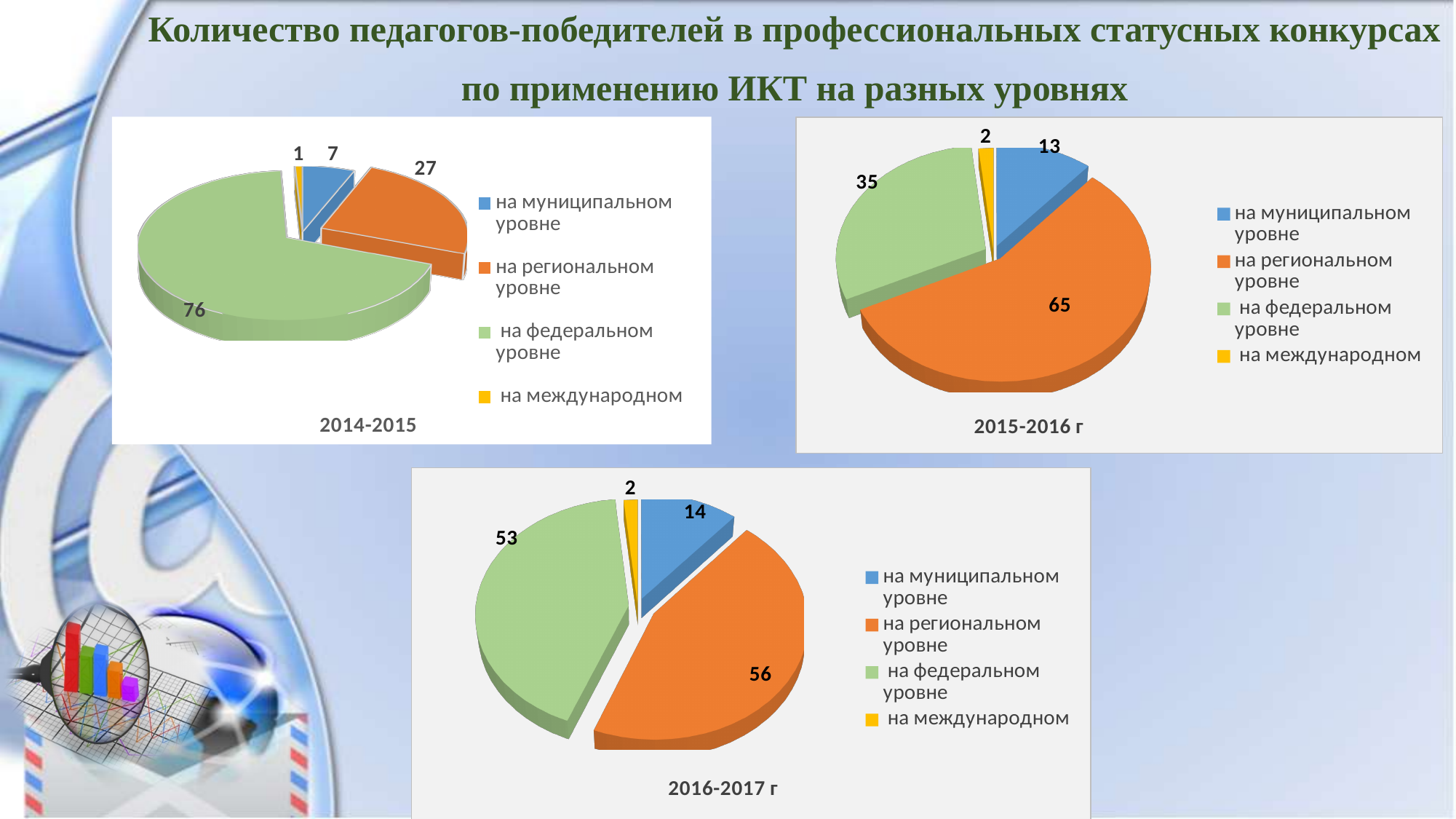
How many slices does the 2014-2015 pie chart have? 4 In the 2016-2017 chart, what is the value for the municipal level (на муниципальном уровне)? 14 In the 2014-2015 chart, what is the value for the federal level (на федеральном уровне)? 76 In the 2014-2015 chart, which level has the largest slice? на федеральном уровне In the 2015-2016 chart, what is the value for the regional level (на региональном уровне)? 65 How many entries does the legend of the 2016-2017 chart list? 4 In the 2015-2016 chart, which is larger: the regional level or the federal level? на региональном уровне In the 2015-2016 chart, which level has the smallest slice? на международном In the 2016-2017 chart, what is the difference between the regional level value and the federal level value? 3 In the 2016-2017 chart, what colour is the slice for the international level (на международном)? Yellow In the 2014-2015 chart, what is the total of all four slices? 111 What type of chart is used for the 2015-2016 data? Pie chart